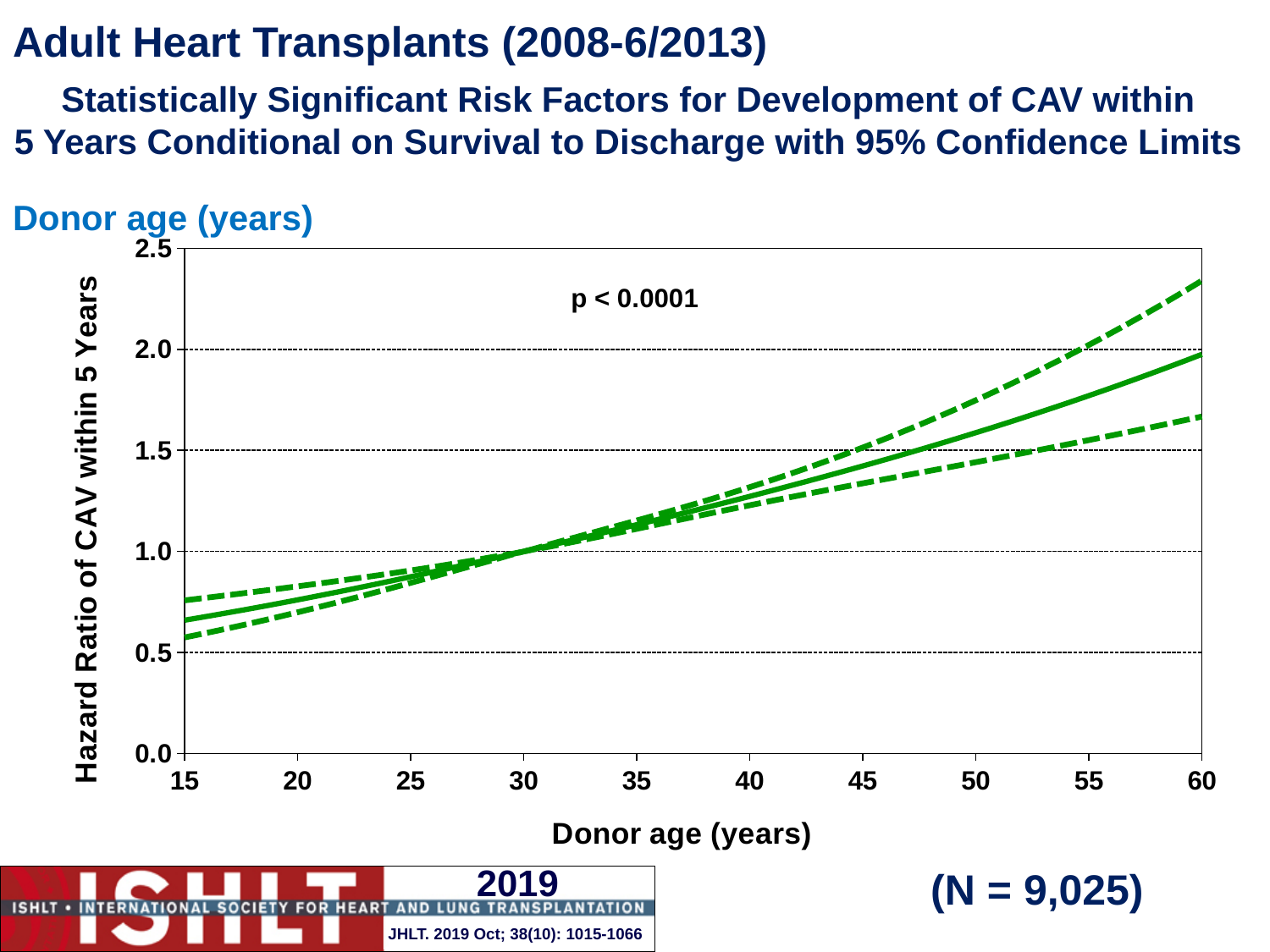
How many lines are plotted on the chart? 3 Is the hazard ratio (solid line) at donor age 45 greater or less than 1.0? greater What sample size (N) is shown on the slide? N = 9,025 Is the hazard ratio (solid line) at donor age 60 greater or less than 1.5? greater Which donor age has the larger hazard ratio on the solid line, 15 years or 60 years? 60 years Is the lower 95% confidence limit (lower dashed line) at donor age 60 greater or less than 2.0? less What kind of chart is shown on the slide? line chart Does the hazard ratio of CAV within 5 years rise or fall as donor age increases? rise What p-value is printed on the chart? p < 0.0001 What is the highest value shown on the y-axis? 2.5